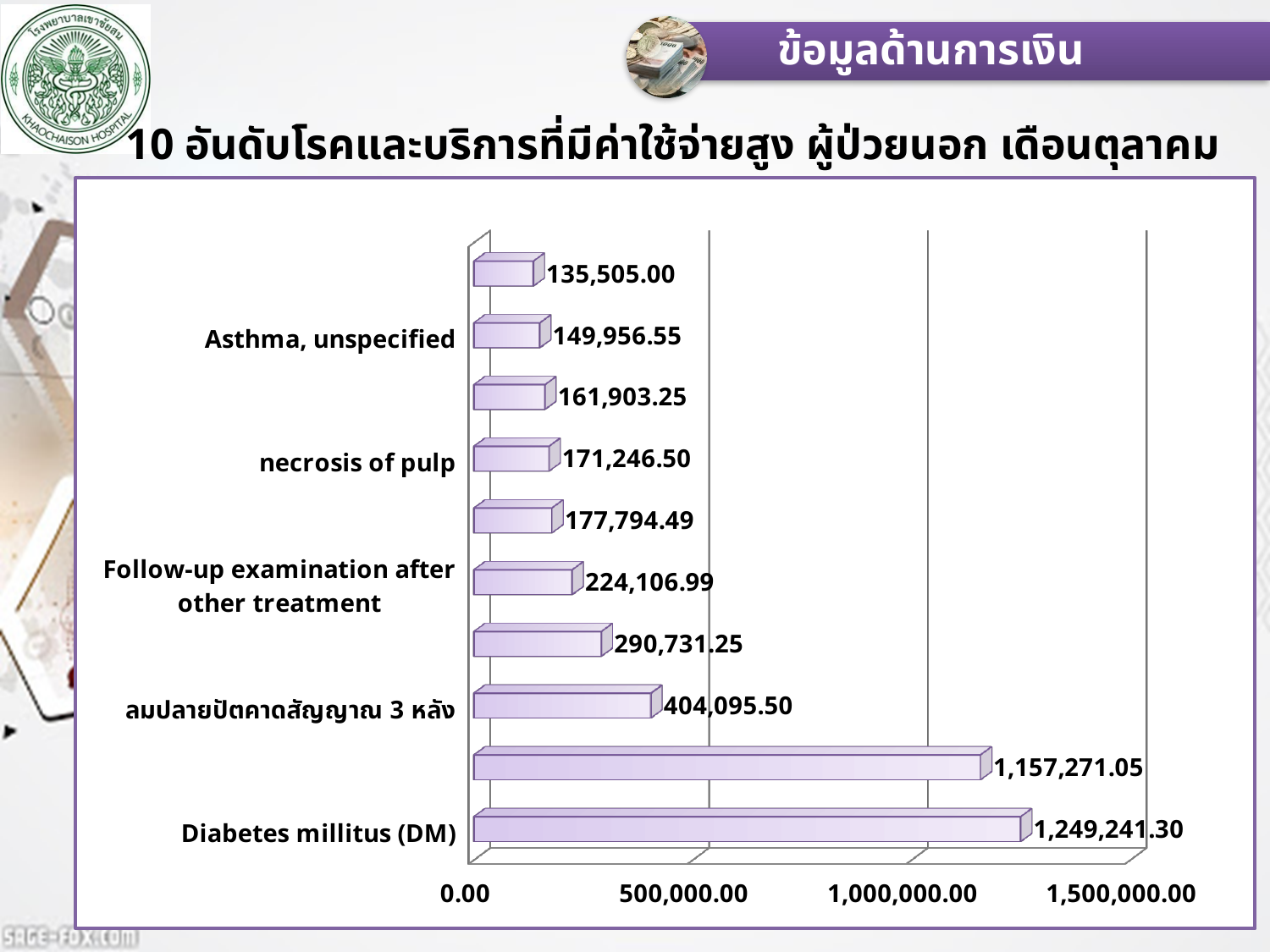
What is the value for Diabetes millitus (DM)? 1,249,241.30 What is the value for Follow-up examination after other treatment? 224,106.99 What is the value for ลมปลายปัตคาดสัญญาณ 3 หลัง? 404,095.50 What is the value for necrosis of pulp? 171,246.50 What is the smallest value shown in the chart? 135,505.00 Which is larger, the value for Follow-up examination after other treatment or the value for necrosis of pulp? Follow-up examination after other treatment What is the value for Asthma, unspecified? 149,956.55 Is the value for Diabetes millitus (DM) greater or less than 1,000,000.00? greater Which category has the highest value in the chart? Diabetes millitus (DM) What type of chart is shown on the slide? bar chart What is the difference between the values for Diabetes millitus (DM) and Asthma, unspecified? 1,099,284.75 How many bars are plotted in the chart? 10